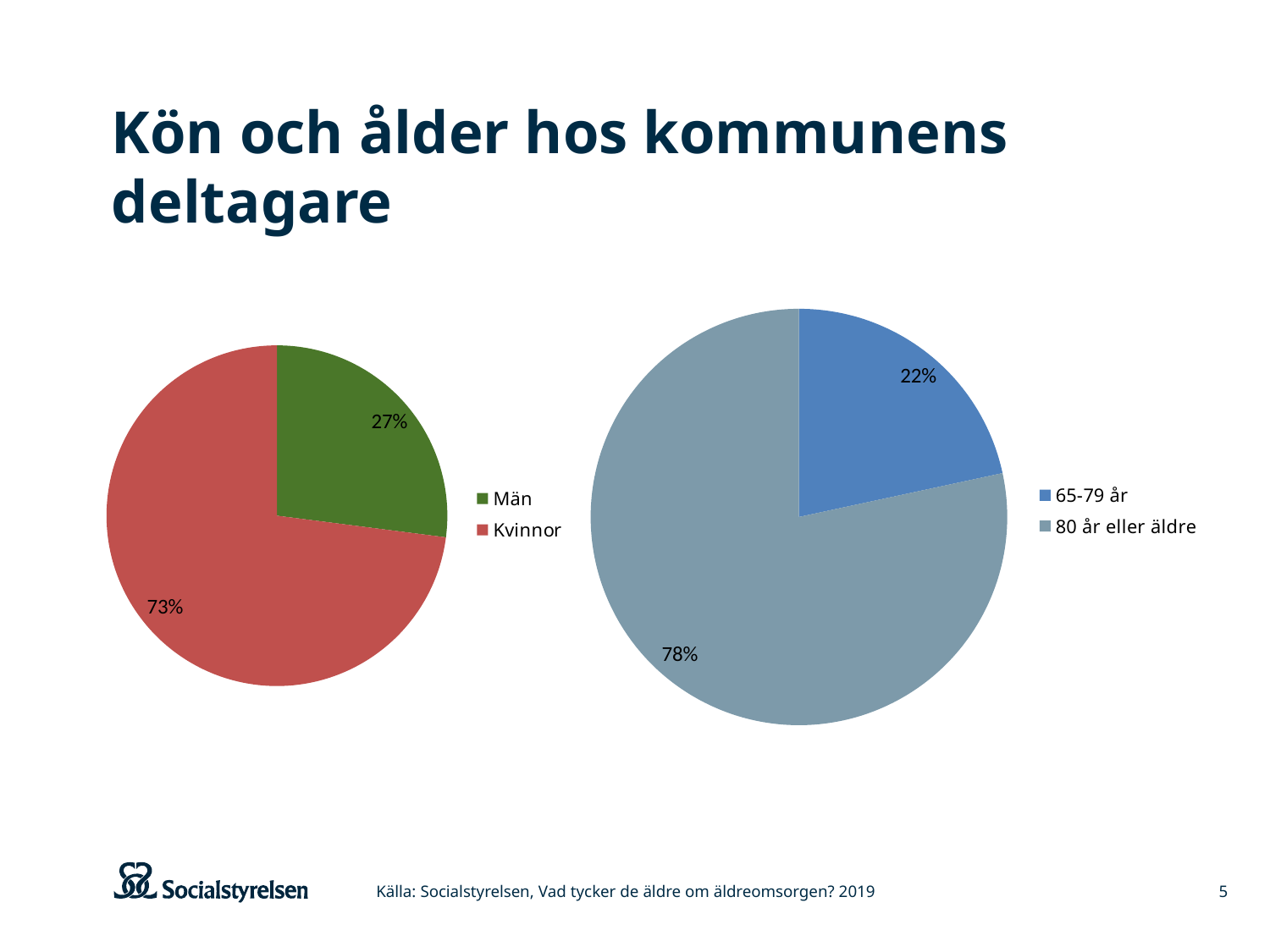
In the right pie chart (age), what colour is the slice for 65-79 år? Blue How many slices does the left pie chart (gender) have? 2 In the right pie chart (age), which category has the smallest slice? 65-79 år In the left pie chart (gender), what share is labelled for Kvinnor? 73% In the right pie chart (age), which is larger: 65-79 år or 80 år eller äldre? 80 år eller äldre In the left pie chart (gender), which category has the largest slice? Kvinnor In the right pie chart (age), what is the difference in percentage points between 80 år eller äldre and 65-79 år? 56 In the right pie chart (age), what share is labelled for 80 år eller äldre? 78% What type of chart is the right chart (age)? Pie chart In the left pie chart (gender), what is the difference in percentage points between Kvinnor and Män? 46 In the left pie chart (gender), what share is labelled for Män? 27% In the right pie chart (age), what share is labelled for 65-79 år? 22%